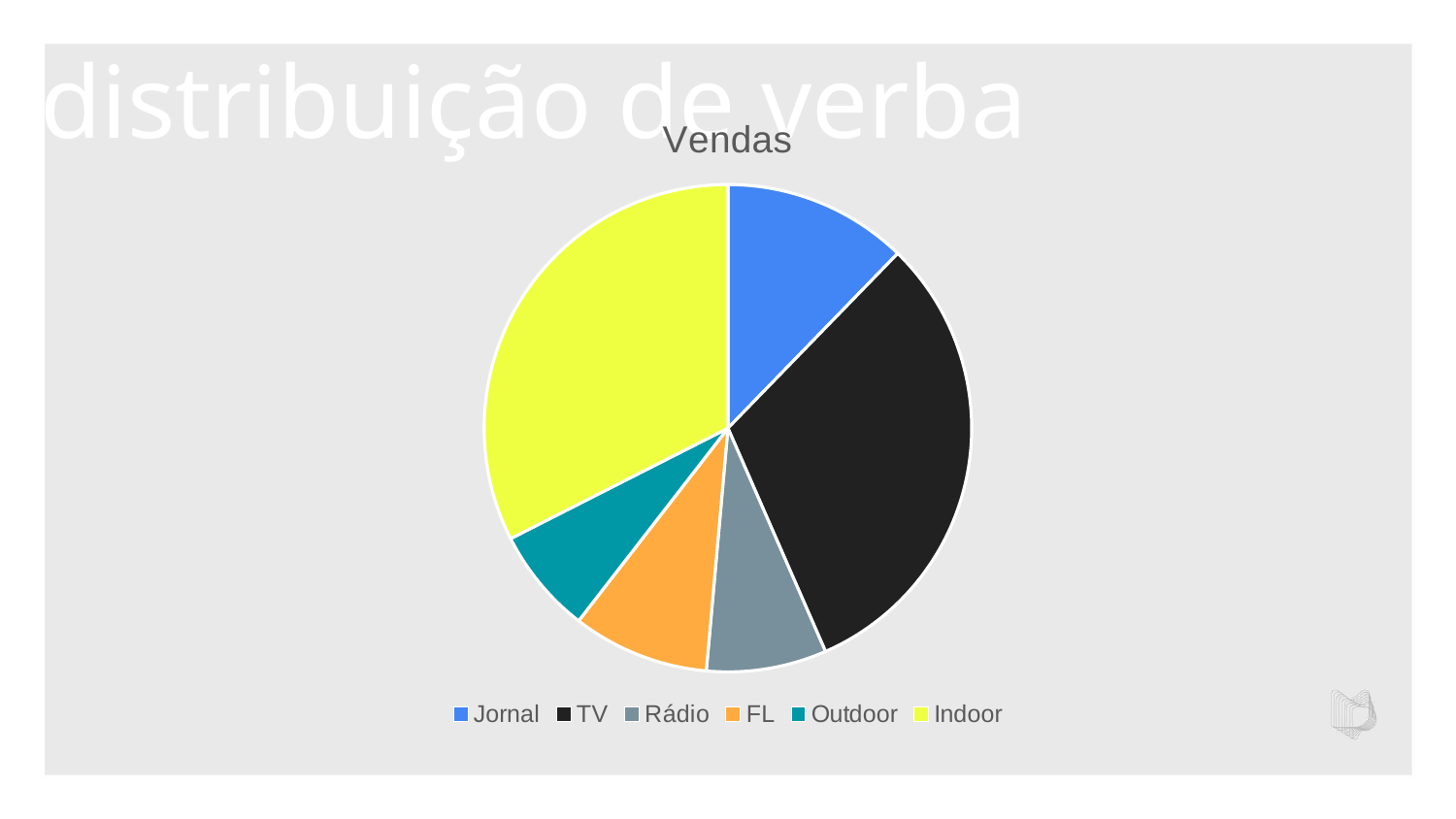
How many slices does the pie chart have? 6 How many entries does the legend of the pie chart list? 6 Which slice is larger in the pie chart, TV or Outdoor? TV What is the title of the pie chart? Vendas Which slice is larger in the pie chart, Indoor or Jornal? Indoor What kind of chart is shown on the slide? pie chart Which slice is larger in the pie chart, Jornal or Rádio? Jornal Which legend entry is shown in yellow in the pie chart? Indoor